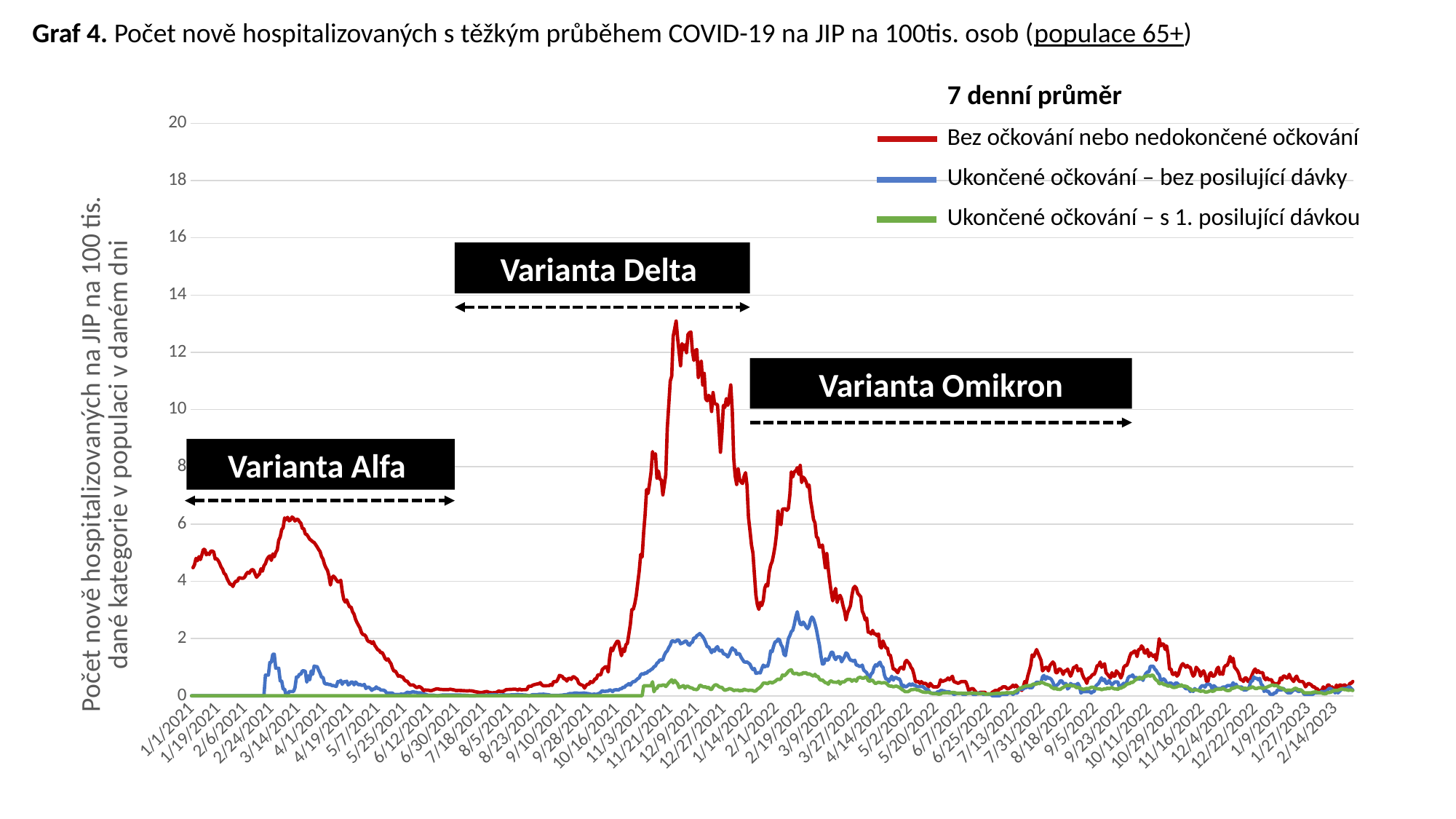
Is the peak value of the 'Bez očkování nebo nedokončené očkování' series around 12/9/2021 greater or less than 12? greater Is the value of the 'Bez očkování nebo nedokončené očkování' series at 1/1/2021 greater or less than 4? greater Around 12/9/2021, which series has the higher value: 'Bez očkování nebo nedokončené očkování' or 'Ukončené očkování – bez posilující dávky'? Bez očkování nebo nedokončené očkování What kind of chart is shown on the slide? line chart Does the 'Bez očkování nebo nedokončené očkování' series rise or fall between 9/28/2021 and 11/21/2021? rise Is the maximum value of the 'Ukončené očkování – s 1. posilující dávkou' series greater or less than 2? less Which variant label is annotated over the period covering 11/21/2021 to 12/27/2021? Varianta Delta What is the highest tick value shown on the y axis? 20 Which series reaches the highest peak on the chart? Bez očkování nebo nedokončené očkování How many series does the legend list? 3 What is the title shown above the legend? 7 denní průměr